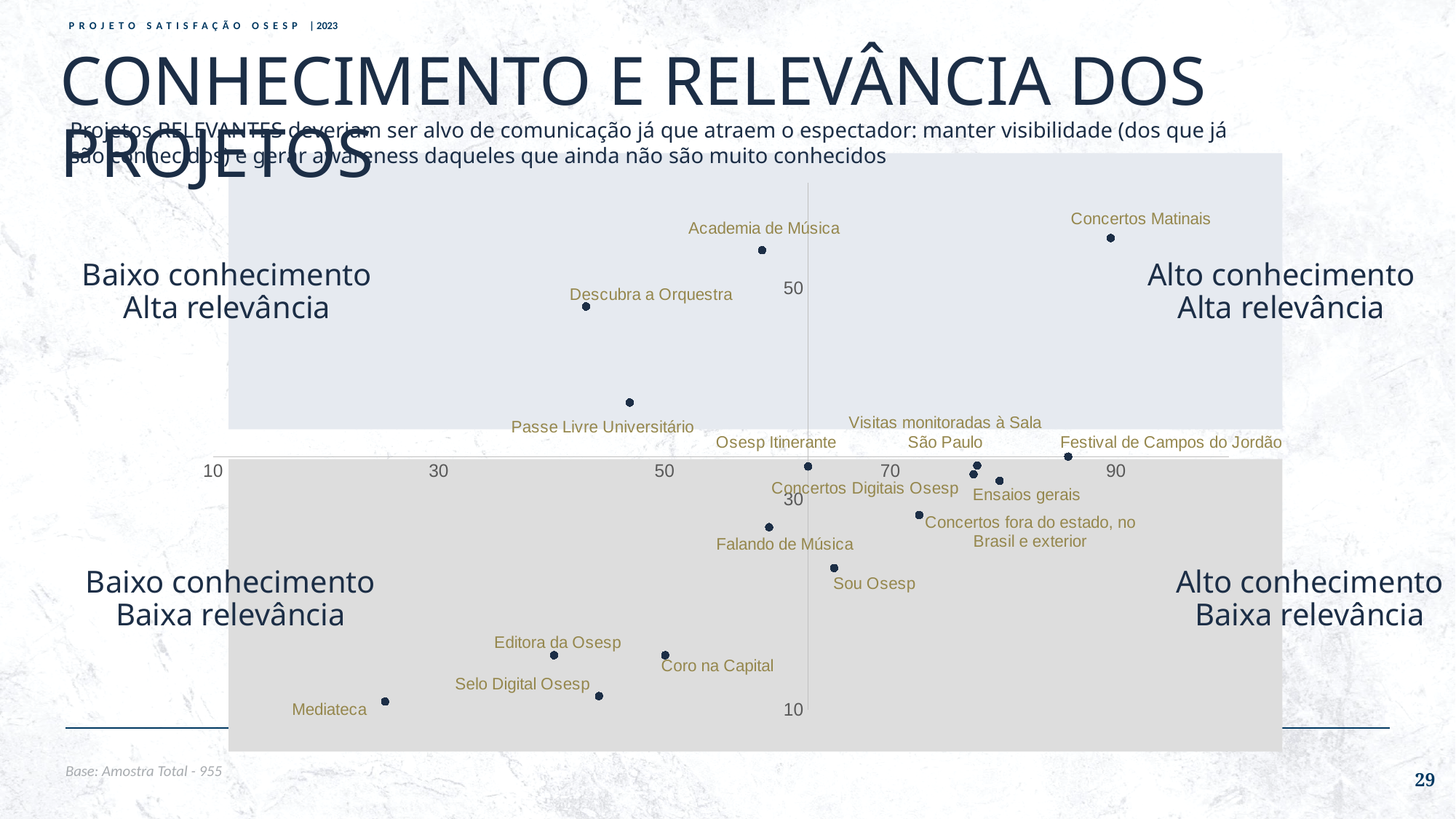
Is the vertical-axis value for Academia de Música greater or less than 50? greater Is the vertical-axis value for Editora da Osesp greater or less than 30? less Which has a higher vertical-axis (relevância) value, Academia de Música or Sou Osesp? Academia de Música What kind of chart is shown on the slide? Scatter plot Is the horizontal-axis value for Festival de Campos do Jordão greater or less than 70? greater Which project has the lowest value on the horizontal (conhecimento) axis? Mediateca What label describes the top-right quadrant of the chart? Alto conhecimento, Alta relevância Which project has the highest value on the horizontal (conhecimento) axis? Concertos Matinais Which has a higher horizontal-axis (conhecimento) value, Concertos Matinais or Passe Livre Universitário? Concertos Matinais